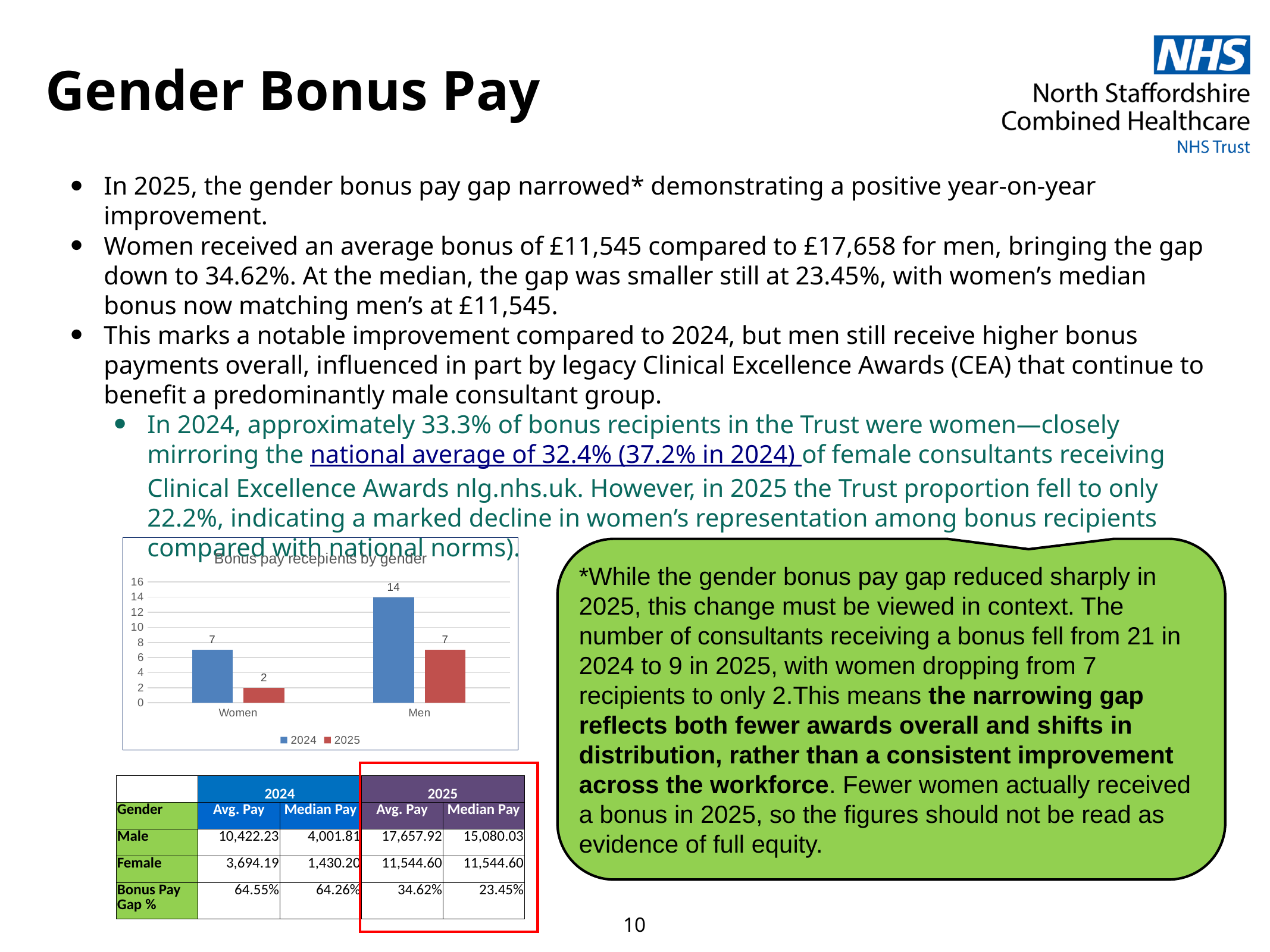
What type of chart is shown on the slide? bar chart What is the title of the chart? Bonus pay recepients by gender What is the value for Women in 2024? 7 What is the value for Men in 2025? 7 How many categories are shown on the x axis of the chart? 2 Which category has the lowest value in the 2025 series? Women What is the value for Men in 2024? 14 What is the value for Women in 2025? 2 Is the value for Men in 2024 greater or less than 10? greater Which category has the highest value in the 2024 series? Men What is the difference between the Men and Women values in 2024? 7 How many series does the chart legend list? 2